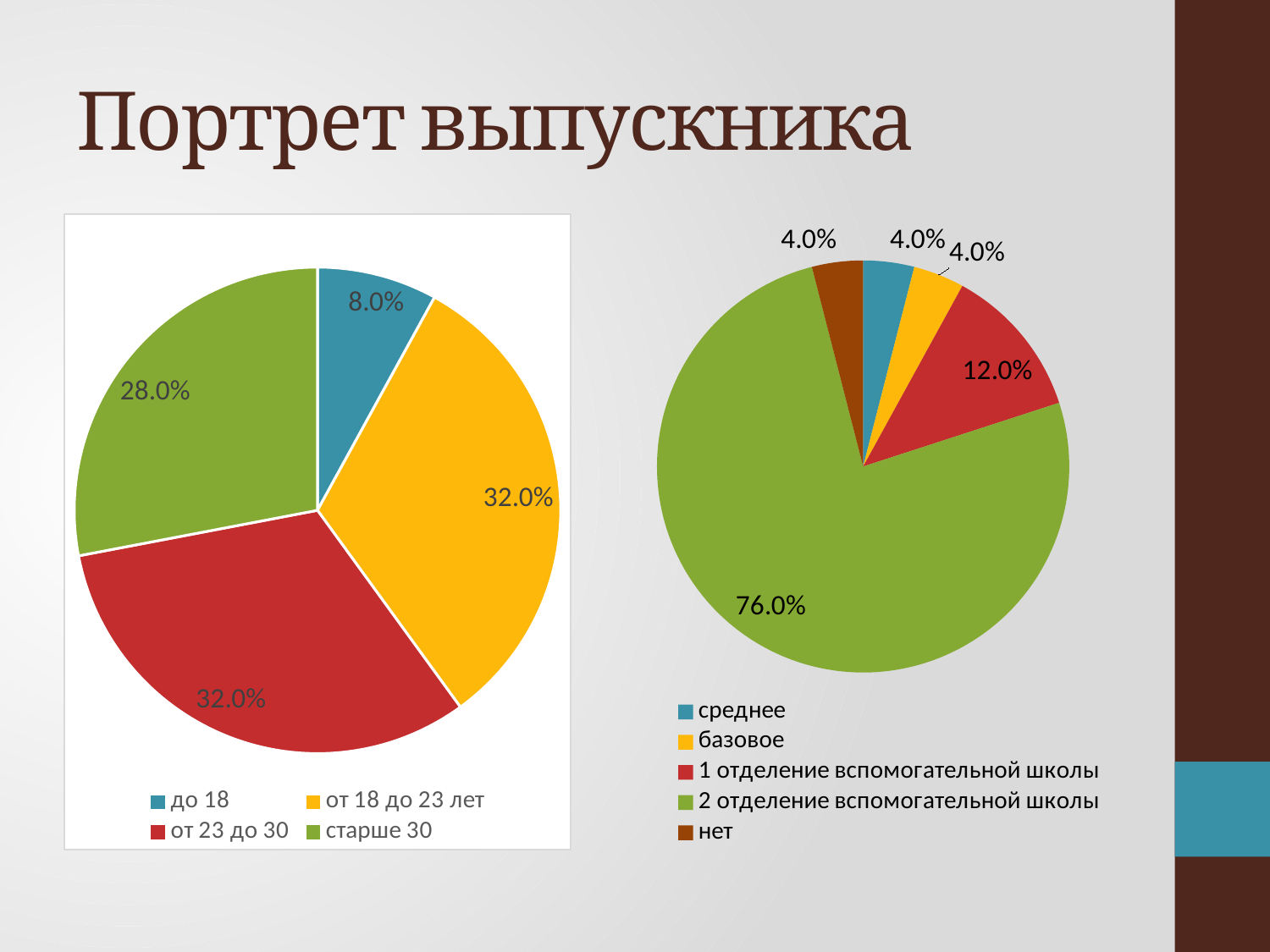
On the left pie chart, what is the difference between the 'старше 30' share and the 'до 18' share? 20.0% On the right pie chart, how many categories does the legend list? 5 On the right pie chart, what share is labelled for '1 отделение вспомогательной школы'? 12.0% On the left pie chart, which category has the smallest slice? до 18 On the left pie chart, what share is labelled for the 'от 18 до 23 лет' slice? 32.0% On the left pie chart, how many categories does the legend list? 4 On the left pie chart, what share is labelled for the 'до 18' slice? 8.0% On the right pie chart, what share is labelled for '2 отделение вспомогательной школы'? 76.0% What type of chart is shown on the right side of the slide? Pie chart On the right pie chart, which category has the largest slice? 2 отделение вспомогательной школы On the right pie chart, which is larger: the share for '1 отделение вспомогательной школы' or the share for 'нет'? 1 отделение вспомогательной школы On the left pie chart, what share is labelled for the 'старше 30' slice? 28.0%